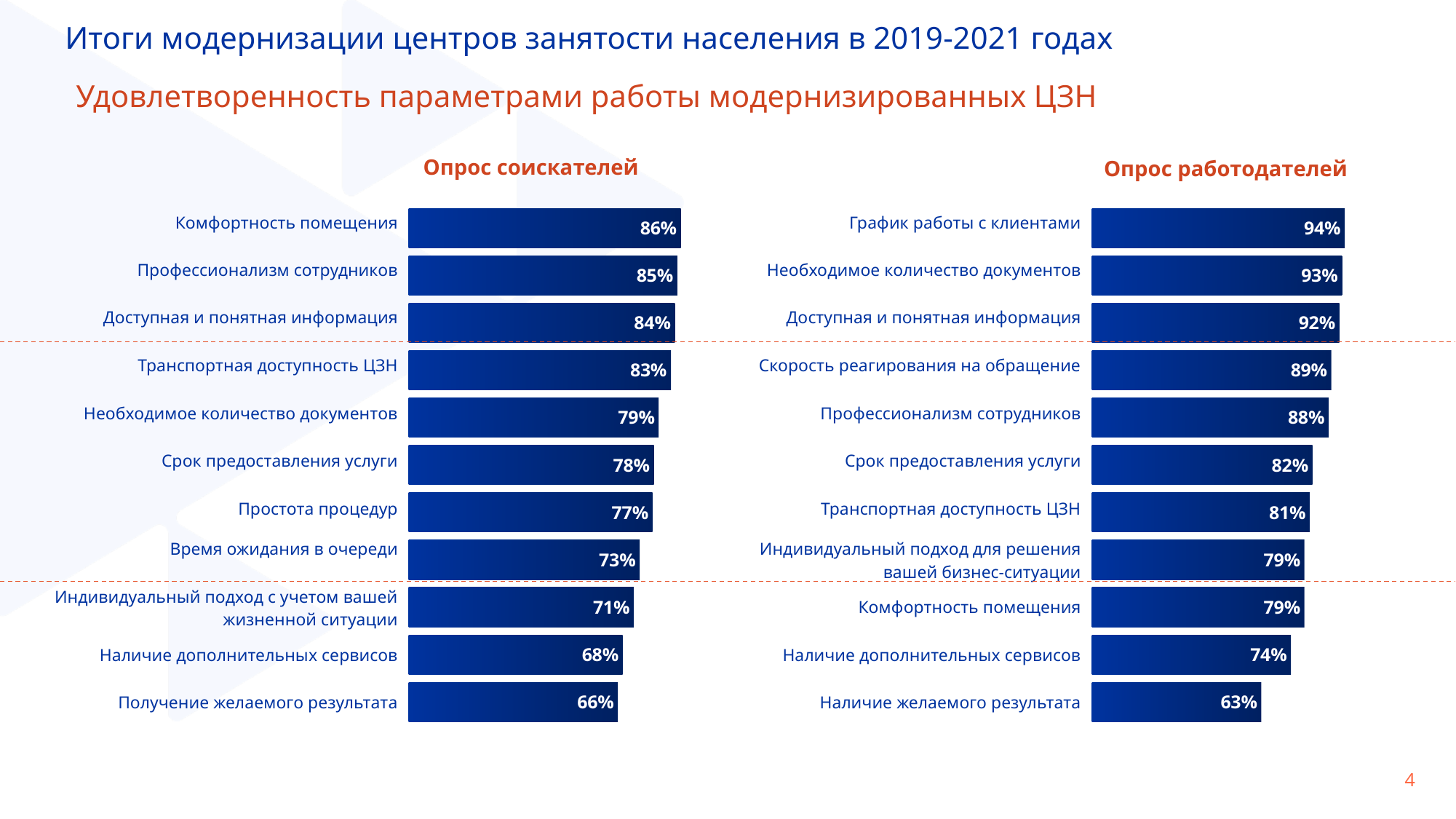
In the 'Опрос соискателей' chart, what is the difference between 'Комфортность помещения' and 'Получение желаемого результата'? 20% In the 'Опрос работодателей' chart, which category has the highest value? График работы с клиентами In the 'Опрос работодателей' chart, what is the value for 'Наличие желаемого результата'? 63% In the 'Опрос работодателей' chart, what is the value for 'Скорость реагирования на обращение'? 89% What kind of chart is the 'Опрос соискателей' chart? Bar chart In the 'Опрос соискателей' chart, what is the value for 'Комфортность помещения'? 86% How many categories are shown in the 'Опрос работодателей' chart? 11 In the 'Опрос работодателей' chart, what is the difference between 'Необходимое количество документов' and 'Наличие дополнительных сервисов'? 19% Which is larger: 'Транспортная доступность ЦЗН' in the 'Опрос соискателей' chart or 'Транспортная доступность ЦЗН' in the 'Опрос работодателей' chart? Опрос соискателей In the 'Опрос соискателей' chart, which category has the lowest value? Получение желаемого результата How many categories are shown in the 'Опрос соискателей' chart? 11 In the 'Опрос соискателей' chart, which is larger: 'Простота процедур' or 'Время ожидания в очереди'? Простота процедур